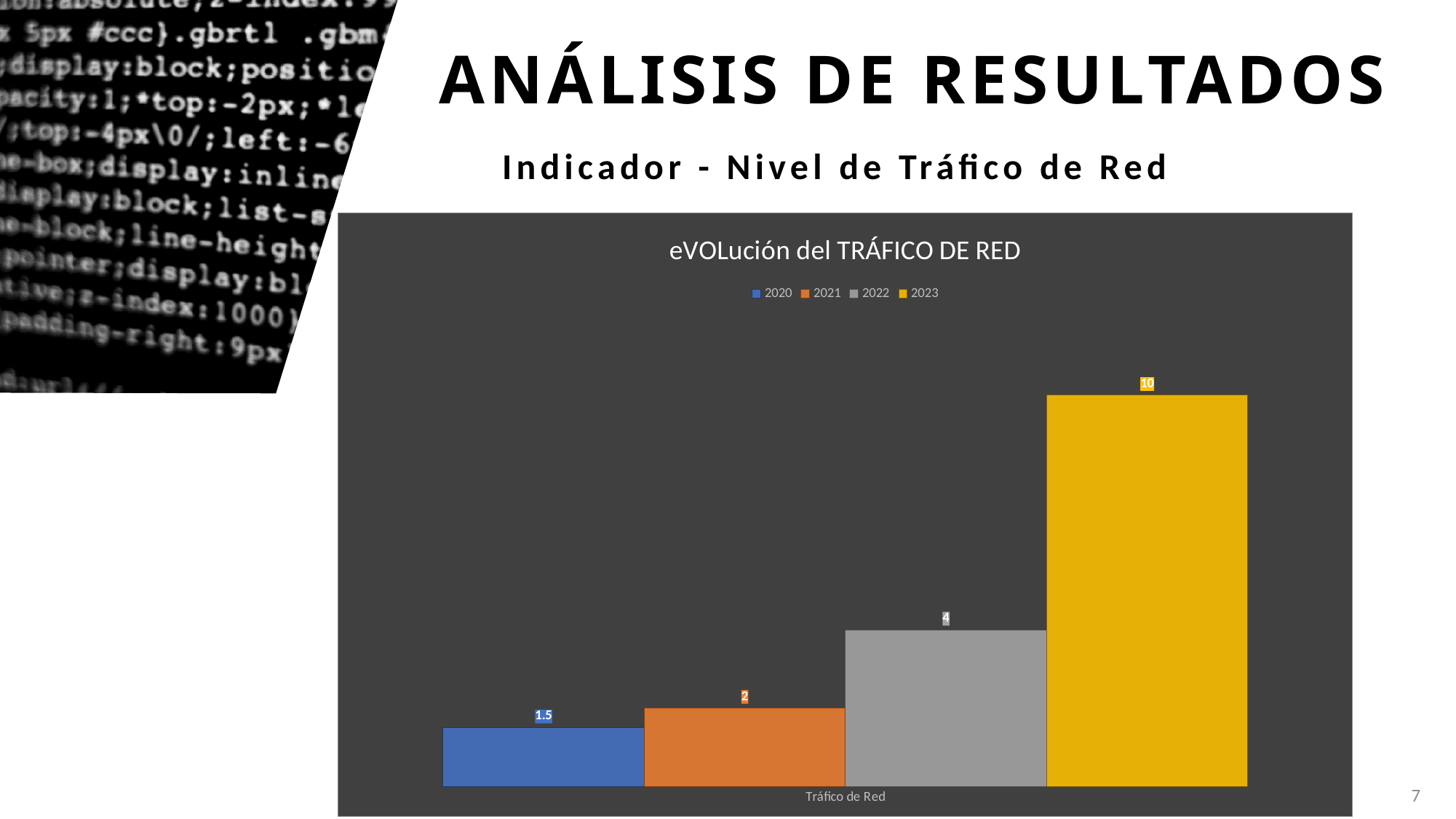
What is the title of the chart? eVOLución del TRÁFICO DE RED Which year has the lowest value in the chart? 2020 Which is larger, the value for 2022 or the value for 2021? 2022 Which year has the highest value in the chart? 2023 What kind of chart is shown on the slide? Bar chart What is the value for 2020 in the chart? 1.5 What is the value for 2023 in the chart? 10 What is the value for 2022 in the chart? 4 What is the difference between the values for 2021 and 2020? 0.5 What is the value for 2021 in the chart? 2 How many series does the legend list? 4 What is the difference between the values for 2023 and 2022? 6